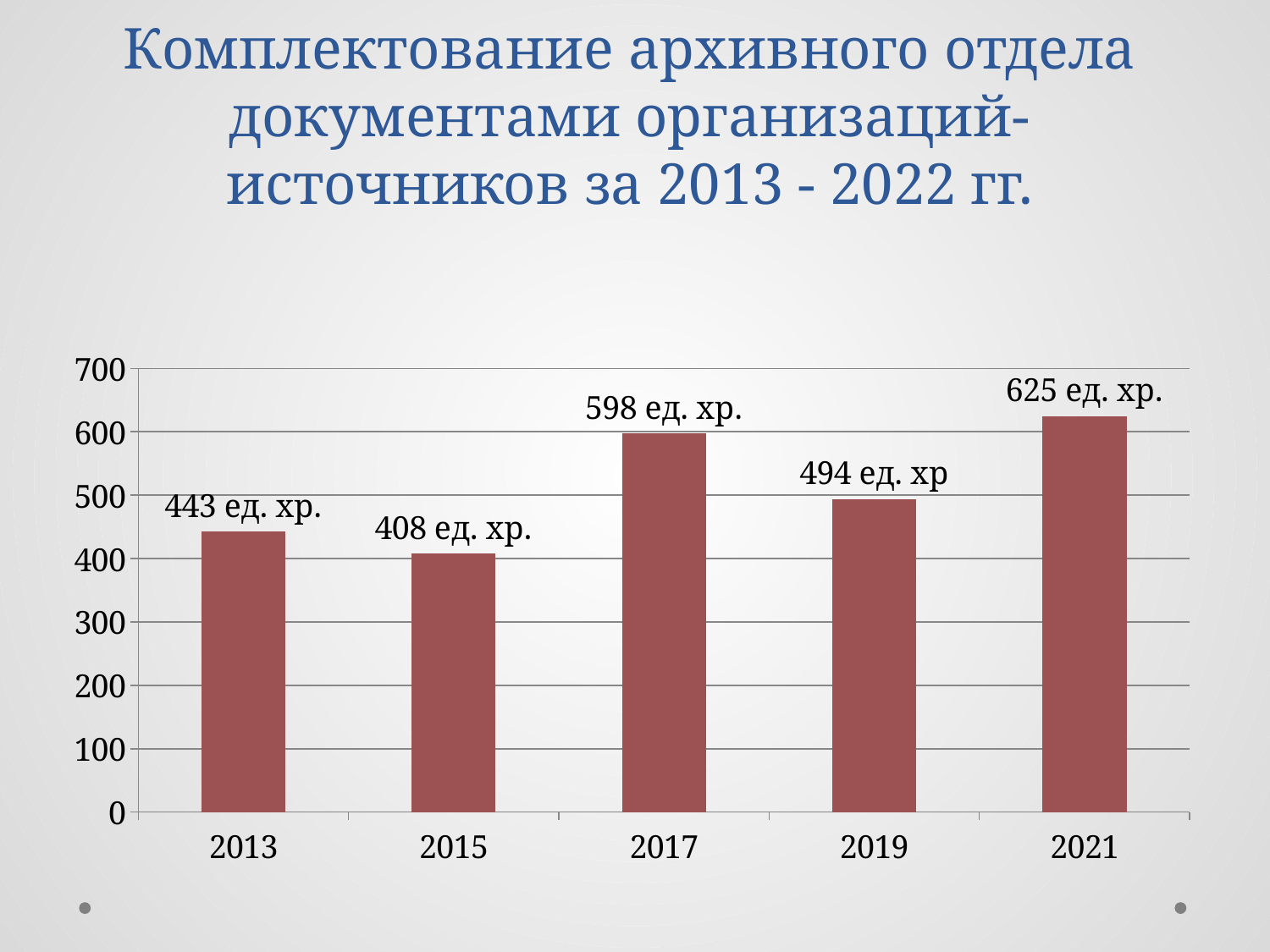
What is the difference between the values for 2021 and 2013? 182 What is the title of the slide? Комплектование архивного отдела документами организаций-источников за 2013 - 2022 гг. What is the difference between the values for 2017 and 2019? 104 What kind of chart is shown on the slide? bar chart How many years are shown on the x axis? 5 What is the value for 2017? 598 ед. хр. Which year has the lowest value? 2015 Is the value for 2017 greater or less than 500? greater What is the value for 2013? 443 ед. хр. What is the value for 2021? 625 ед. хр. Which is larger, the value for 2015 or the value for 2019? 2019 Which year has the highest value? 2021